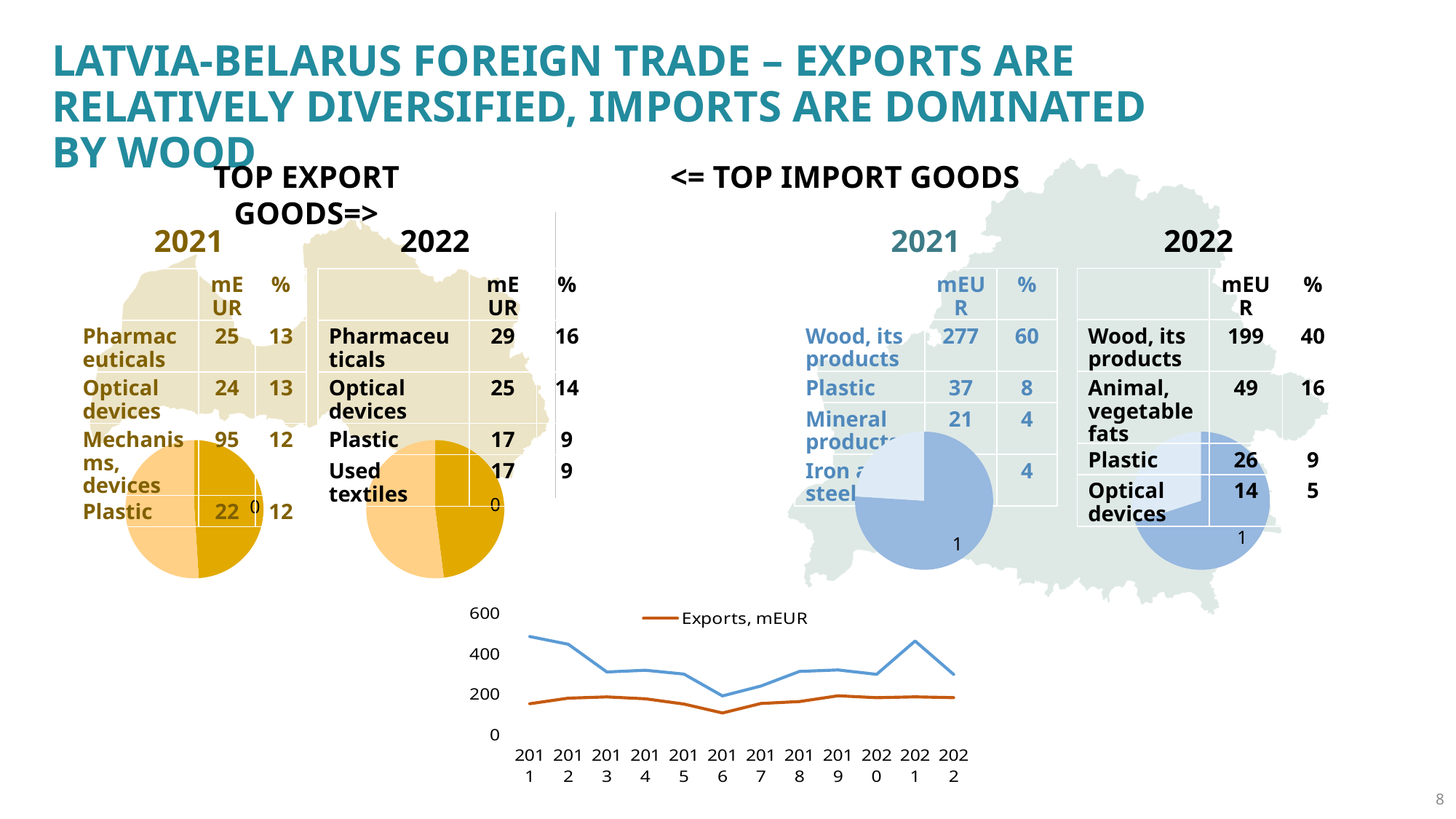
What series name is shown in the legend of the line chart at the bottom of the slide? Exports, mEUR What kind of chart is shown at the bottom of the slide with the years 2011 to 2022 on the x axis? line chart How many slices does the orange pie chart under the 2022 export table have? 2 How many years are shown on the x axis of the line chart at the bottom of the slide? 12 In the line chart at the bottom of the slide, does the blue line rise or fall from 2011 to 2016? fall In the line chart at the bottom of the slide, in which year is the Exports, mEUR line at its lowest? 2016 In the line chart at the bottom of the slide, is the value of the blue line for 2021 greater or less than 400? greater In the line chart at the bottom of the slide, is the value of Exports, mEUR for 2016 greater or less than 200? less In the line chart at the bottom of the slide, is the value of the blue line for 2022 greater or less than 400? less In the line chart at the bottom of the slide, which is higher in 2011: the blue line or the Exports, mEUR line? the blue line How many pie charts are shown on the slide? 4